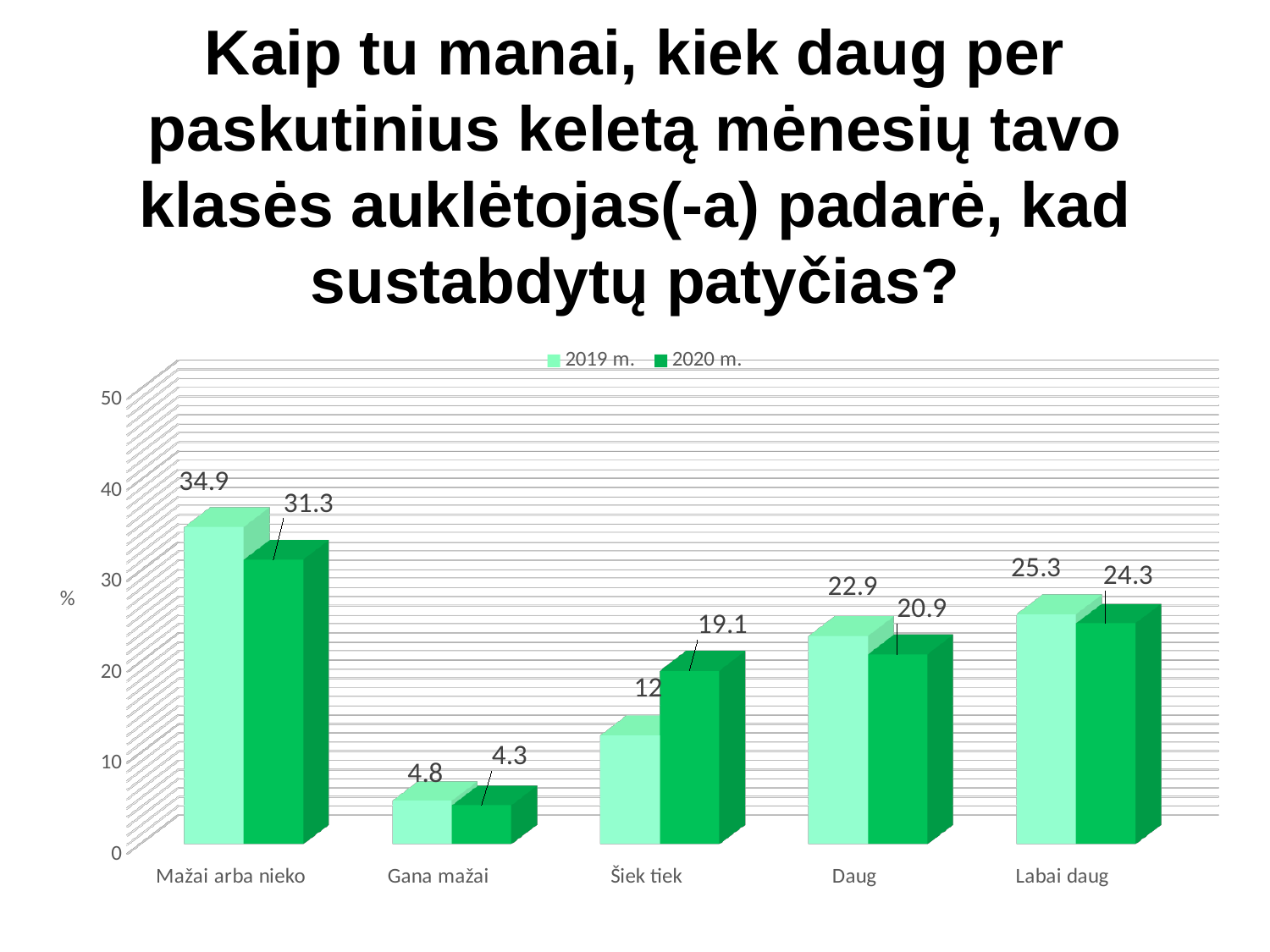
What is the difference between the 2019 m. and 2020 m. values for "Šiek tiek"? 7.1 Which is larger for "Labai daug": the 2019 m. value or the 2020 m. value? 2019 m. What is the value for "Daug" in the 2019 m. series? 22.9 What is the value for "Mažai arba nieko" in the 2019 m. series? 34.9 What is the value for "Šiek tiek" in the 2020 m. series? 19.1 Which category has the highest value in the 2020 m. series? Mažai arba nieko How many categories are shown on the x axis? 5 What are the two series named in the legend? 2019 m. and 2020 m. Which category has the lowest value in the 2019 m. series? Gana mažai How many series does the legend list? 2 Is the 2020 m. value for "Mažai arba nieko" greater or less than 30? greater What kind of chart is shown on the slide? bar chart